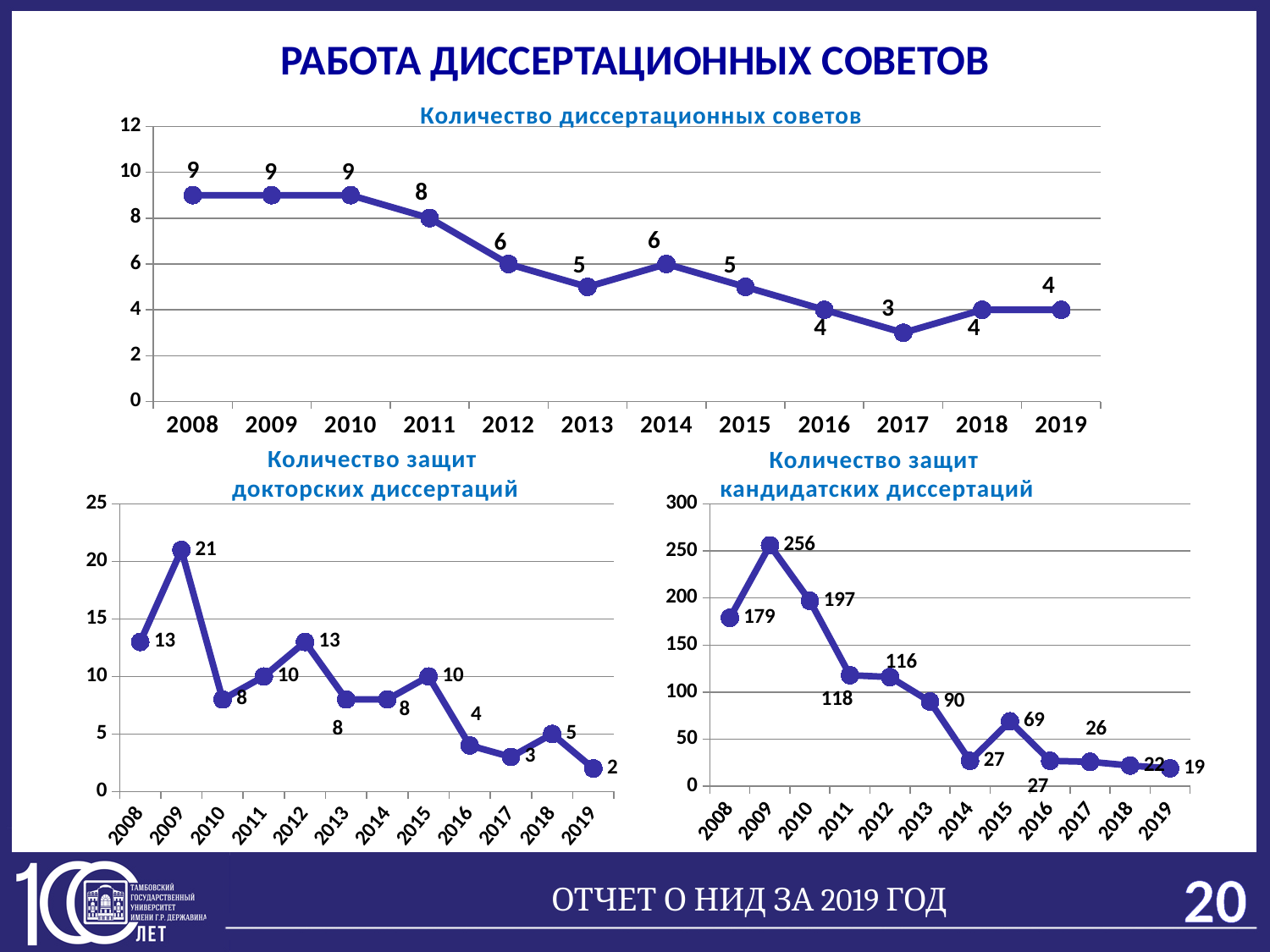
In the chart 'Количество защит кандидатских диссертаций', what is the value for 2013? 90 In the chart 'Количество диссертационных советов', do the values generally rise or fall from 2008 to 2019? fall In the chart 'Количество защит докторских диссертаций', which year has the highest value? 2009 What type of chart is used for 'Количество защит кандидатских диссертаций'? line chart In the chart 'Количество диссертационных советов', which year has the lowest value? 2017 In the chart 'Количество диссертационных советов', how many data points are plotted? 12 In the chart 'Количество защит докторских диссертаций', what is the difference between the values for 2009 and 2010? 13 In the chart 'Количество защит кандидатских диссертаций', what is the difference between the values for 2009 and 2008? 77 In the chart 'Количество диссертационных советов', what is the value for 2011? 8 In the chart 'Количество защит докторских диссертаций', what is the value for 2009? 21 In the chart 'Количество защит кандидатских диссертаций', which year has the lowest value? 2019 In the chart 'Количество защит докторских диссертаций', which is larger, the value for 2015 or the value for 2016? 2015